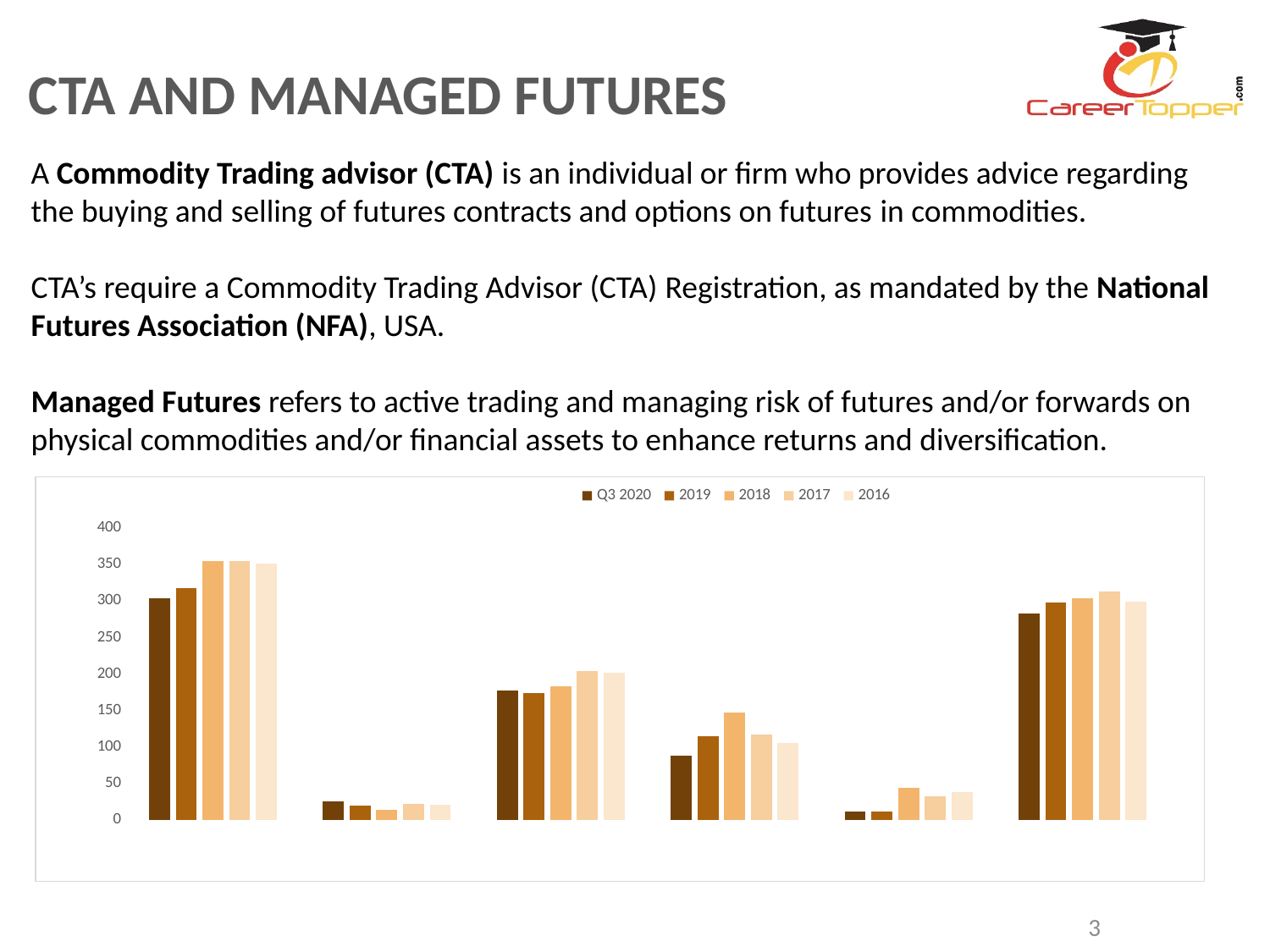
How many groups of bars are plotted along the x axis of the chart? 6 In the leftmost group of bars, is the Q3 2020 value greater or less than 250? greater Which series is listed first in the chart's legend? Q3 2020 In the second group of bars from the left, is the Q3 2020 value greater or less than 50? less In the leftmost group of bars, is the 2018 value larger or smaller than the Q3 2020 value? larger In the fifth group of bars from the left, is the 2018 value greater or less than 100? less How many series does the chart's legend list? 5 What kind of chart is shown on the slide? Bar chart What is the highest value shown on the chart's vertical axis? 400 Which series is listed last in the chart's legend? 2016 In the fourth group of bars from the left, which series has the tallest bar? 2018